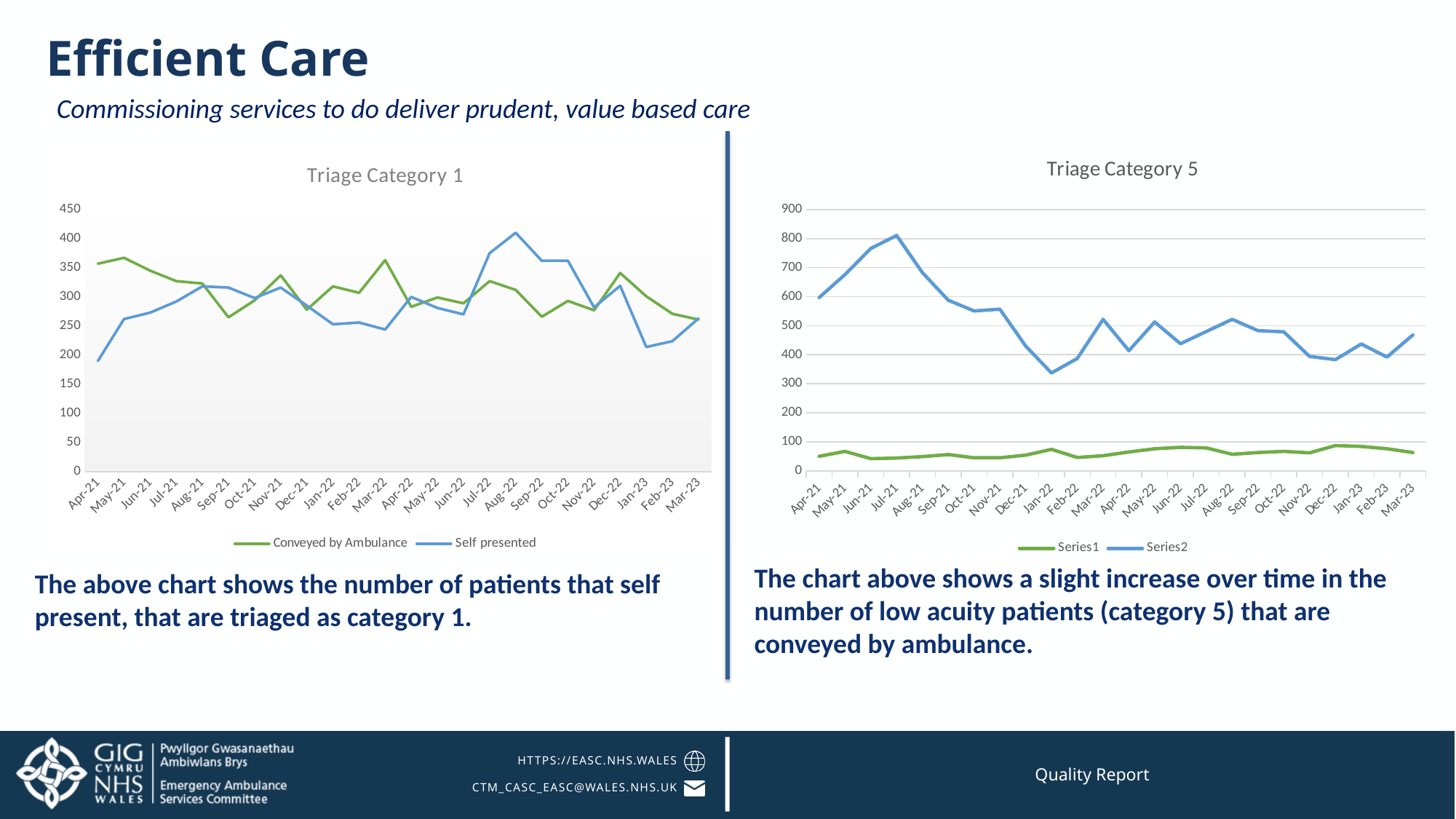
In the Triage Category 5 chart, which series is higher in Mar-23, Series1 or Series2? Series2 In the Triage Category 1 chart, which series is higher in Apr-21, Conveyed by Ambulance or Self presented? Conveyed by Ambulance What kind of chart is the Triage Category 1 chart? line chart In the Triage Category 5 chart, in which month does Series2 reach its highest value? Jul-21 In the Triage Category 5 chart, is the Series2 value for Jul-21 greater or less than 700? greater In the Triage Category 1 chart, is the Self presented value for Aug-22 greater or less than 350? greater In the Triage Category 1 chart, is the Self presented value for Apr-21 greater or less than 250? less In the Triage Category 1 chart, in which month is the Self presented line at its lowest? Apr-21 In the Triage Category 1 chart, in which month does the Self presented line reach its highest value? Aug-22 What are the two legend entries of the Triage Category 5 chart? Series1 and Series2 How many series does the legend of the Triage Category 1 chart list? 2 How many months are plotted along the x axis of the Triage Category 1 chart? 24